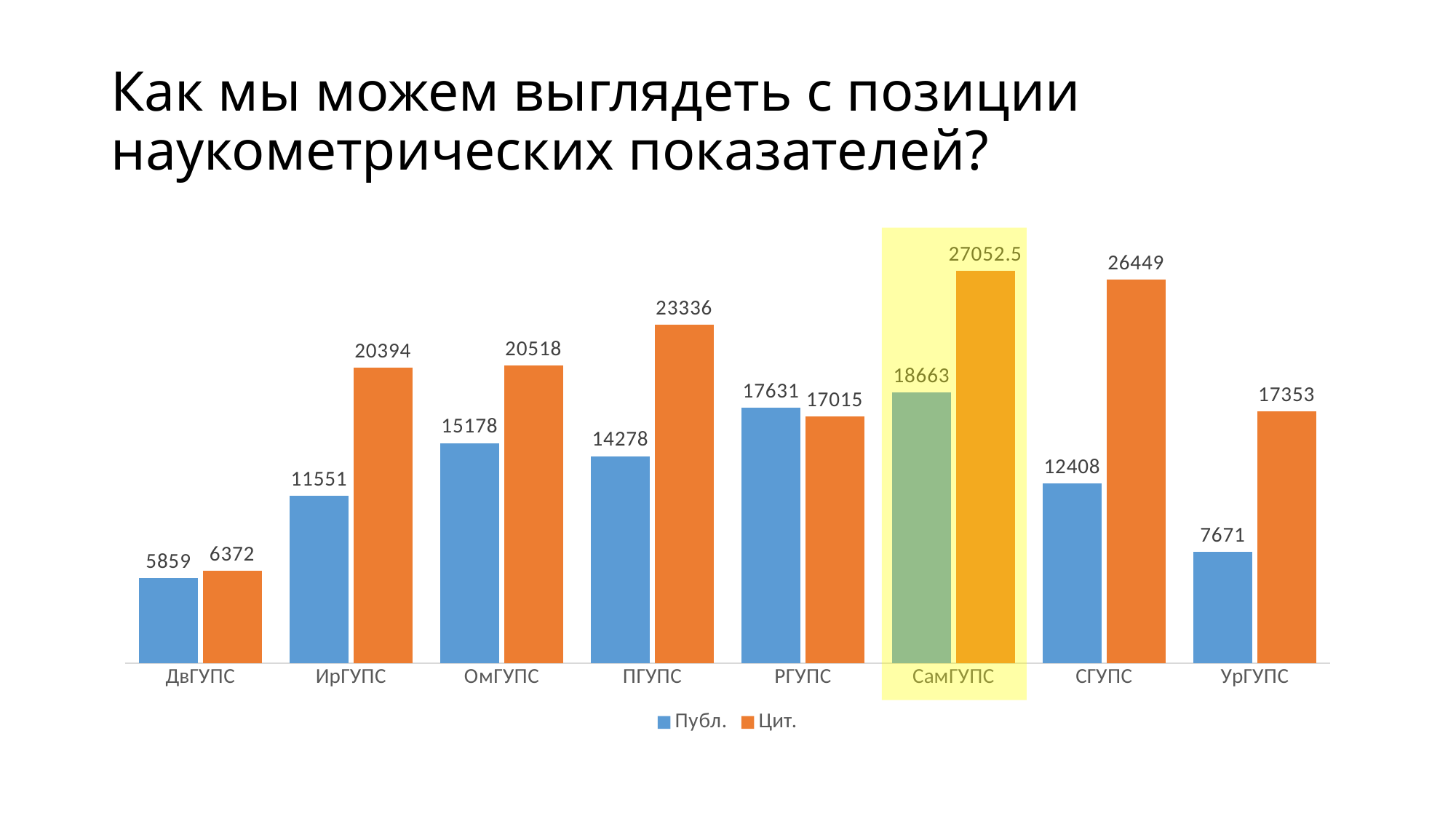
How many categories are shown on the x axis? 8 What is the Публ. value for СамГУПС? 18663 What is the Цит. value for СГУПС? 26449 Which category has the highest Цит. value? СамГУПС What is the difference between the Цит. and Публ. values for ИрГУПС? 8843 What kind of chart is shown on the slide? bar chart Which category has the lowest Публ. value? ДвГУПС What is the difference between the Цит. values for СамГУПС and СГУПС? 603.5 How many series does the legend list? 2 Which is larger for РГУПС, the Публ. value or the Цит. value? Публ. What is the Публ. value for ДвГУПС? 5859 Which category is highlighted with a yellow background on the chart? СамГУПС